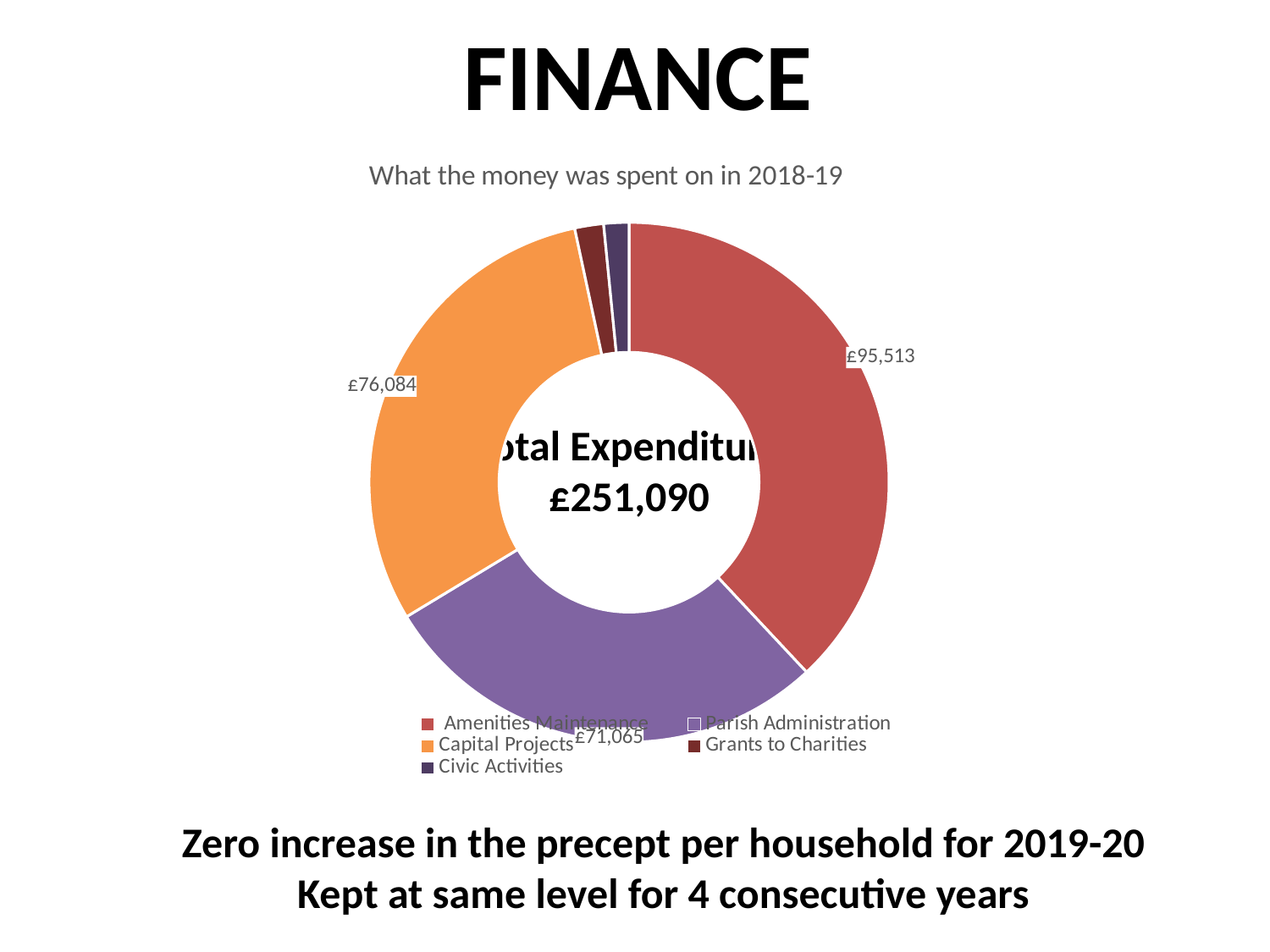
How many spending categories does the chart show? 5 Which is larger: spending on Capital Projects or on Parish Administration? Capital Projects What was spent on Capital Projects according to the chart? £76,084 Which spending category has the largest slice of the chart? Amenities Maintenance What was spent on Parish Administration according to the chart? £71,065 What total expenditure is shown in the centre of the chart? £251,090 What was spent on Amenities Maintenance according to the chart? £95,513 What kind of chart is shown on the slide? doughnut chart What is the title of the chart? What the money was spent on in 2018-19 What is the difference between spending on Capital Projects and Parish Administration? £5,019 How much more was spent on Amenities Maintenance than on Capital Projects? £19,429 What share of the total expenditure of £251,090 went to Amenities Maintenance (£95,513)? 38%